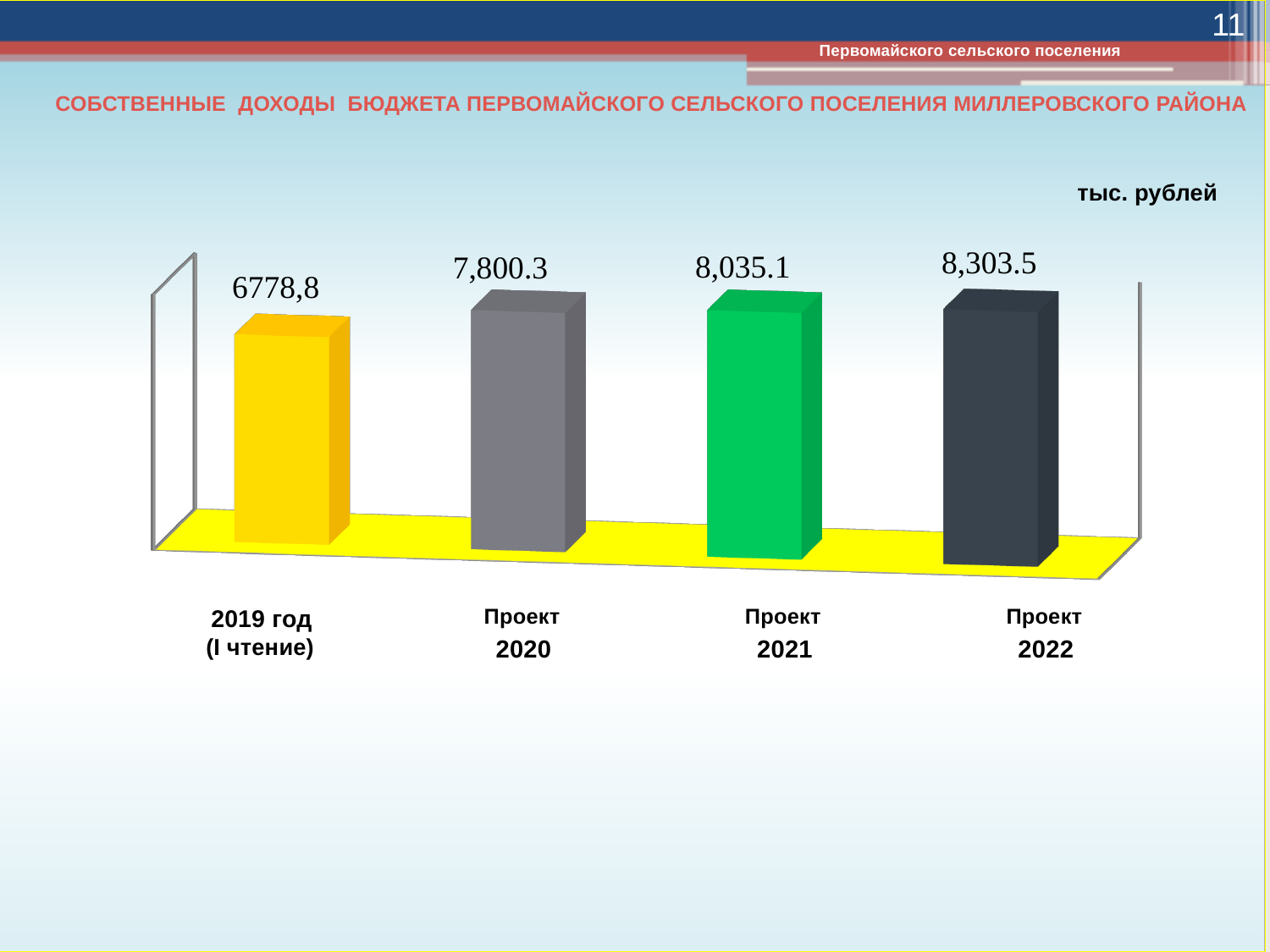
What is the value shown for 2019 год (I чтение)? 6778,8 What is the value shown for Проект 2021? 8,035.1 What kind of chart is shown on the slide? Bar chart What is the difference between the values for Проект 2021 and Проект 2020? 234.8 Which category has the lowest value? 2019 год (I чтение) Which category has the highest value? Проект 2022 What is the difference between the values for Проект 2022 and Проект 2021? 268.4 How many bars are shown in the chart? 4 What is the value shown for Проект 2022? 8,303.5 Which is larger, the value for Проект 2020 or the value for 2019 год (I чтение)? Проект 2020 Do the values rise or fall from 2019 год (I чтение) to Проект 2022? Rise What is the value shown for Проект 2020? 7,800.3